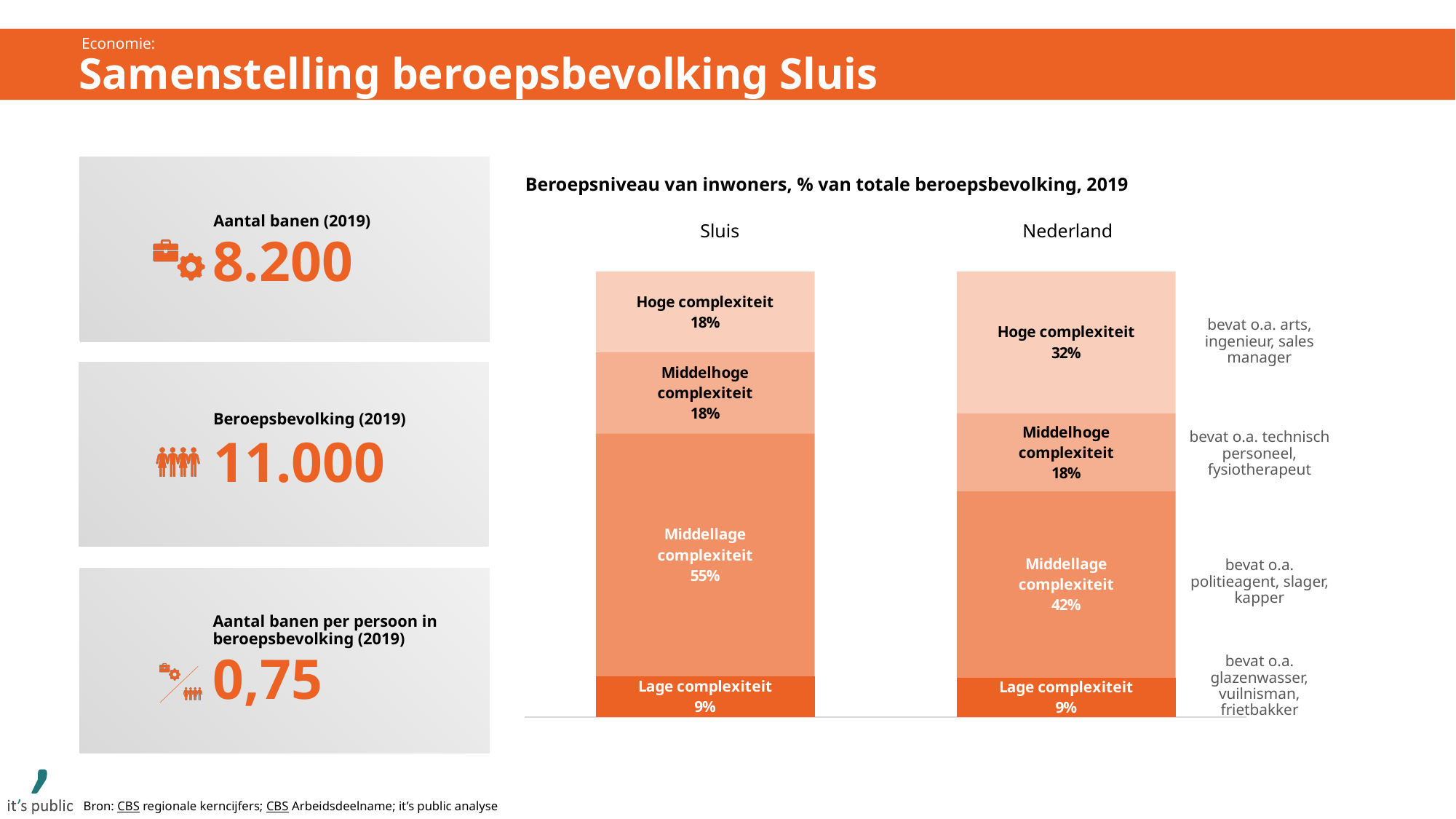
Which segment is the largest in the Sluis bar? Middellage complexiteit What is the difference between the 'Hoge complexiteit' share for Nederland and for Sluis? 14 percentage points What type of chart is shown under the title 'Beroepsniveau van inwoners, % van totale beroepsbevolking, 2019'? Stacked bar chart Which segment is the smallest in the Nederland bar? Lage complexiteit What is the total of the four segments in the Nederland bar? 101% Which has a larger 'Middellage complexiteit' share, Sluis or Nederland? Sluis What is the value for 'Middellage complexiteit' in the Sluis bar? 55% What is the value for 'Hoge complexiteit' in the Nederland bar? 32% What is the value for 'Lage complexiteit' in the Sluis bar? 9% What is the value for 'Middelhoge complexiteit' in the Nederland bar? 18% How many bars are shown in the chart? 2 How many segments does each stacked bar contain? 4